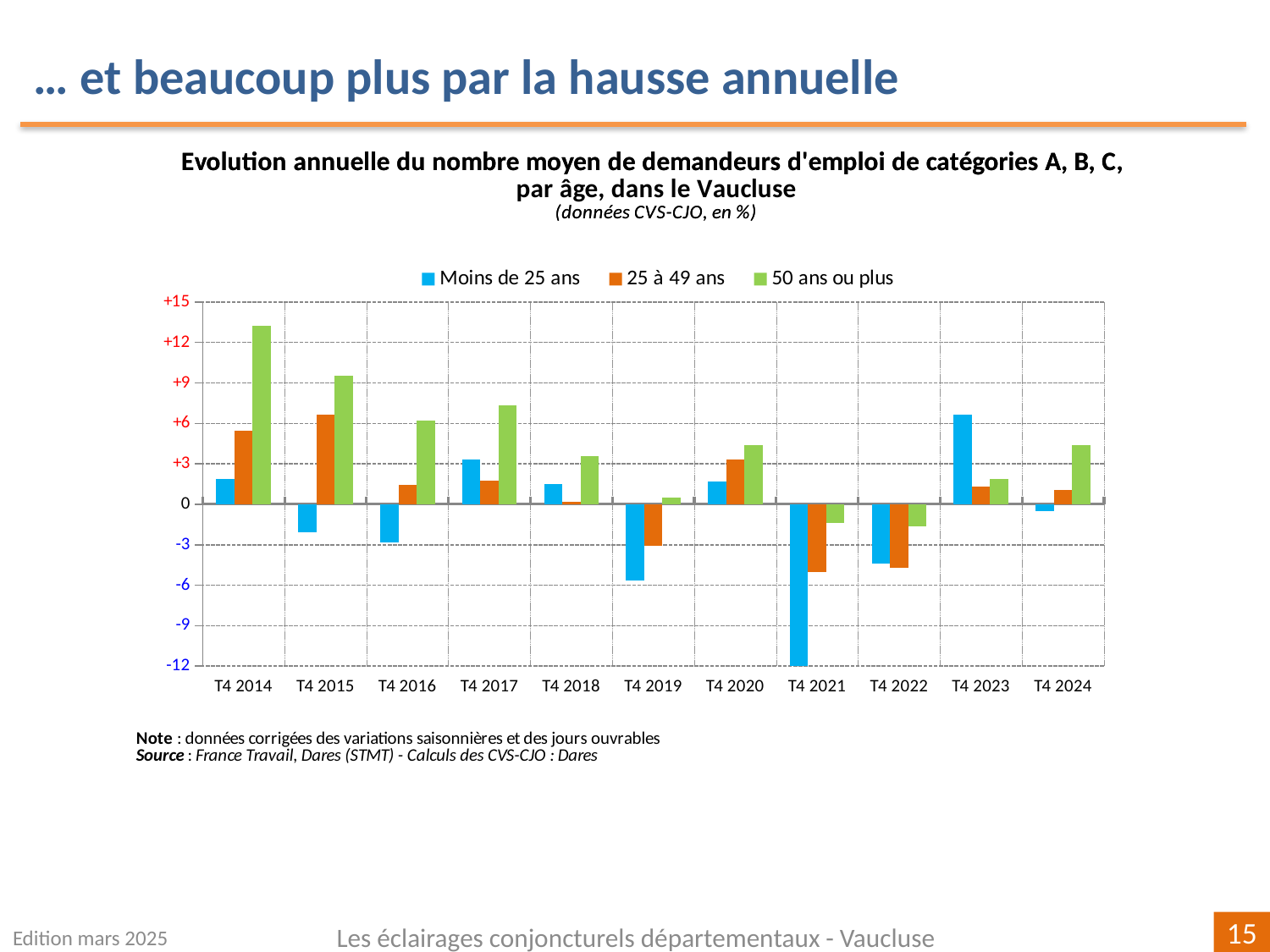
In T4 2017, which is larger: the value for 'Moins de 25 ans' or for '50 ans ou plus'? 50 ans ou plus In which quarter is the value for '50 ans ou plus' the highest? T4 2014 Which colour represents the '50 ans ou plus' series in the legend? green What kind of chart is shown on the slide? bar chart In which quarter is the value for 'Moins de 25 ans' the lowest? T4 2021 Is the value for 'Moins de 25 ans' in T4 2021 greater or less than -9? less How many quarters (categories) are shown on the x axis? 11 In T4 2023, which is larger: the value for 'Moins de 25 ans' or for '25 à 49 ans'? Moins de 25 ans Is the value for '50 ans ou plus' in T4 2014 greater or less than +12? greater Is the value for '50 ans ou plus' in T4 2016 greater or less than +3? greater How many series does the legend list? 3